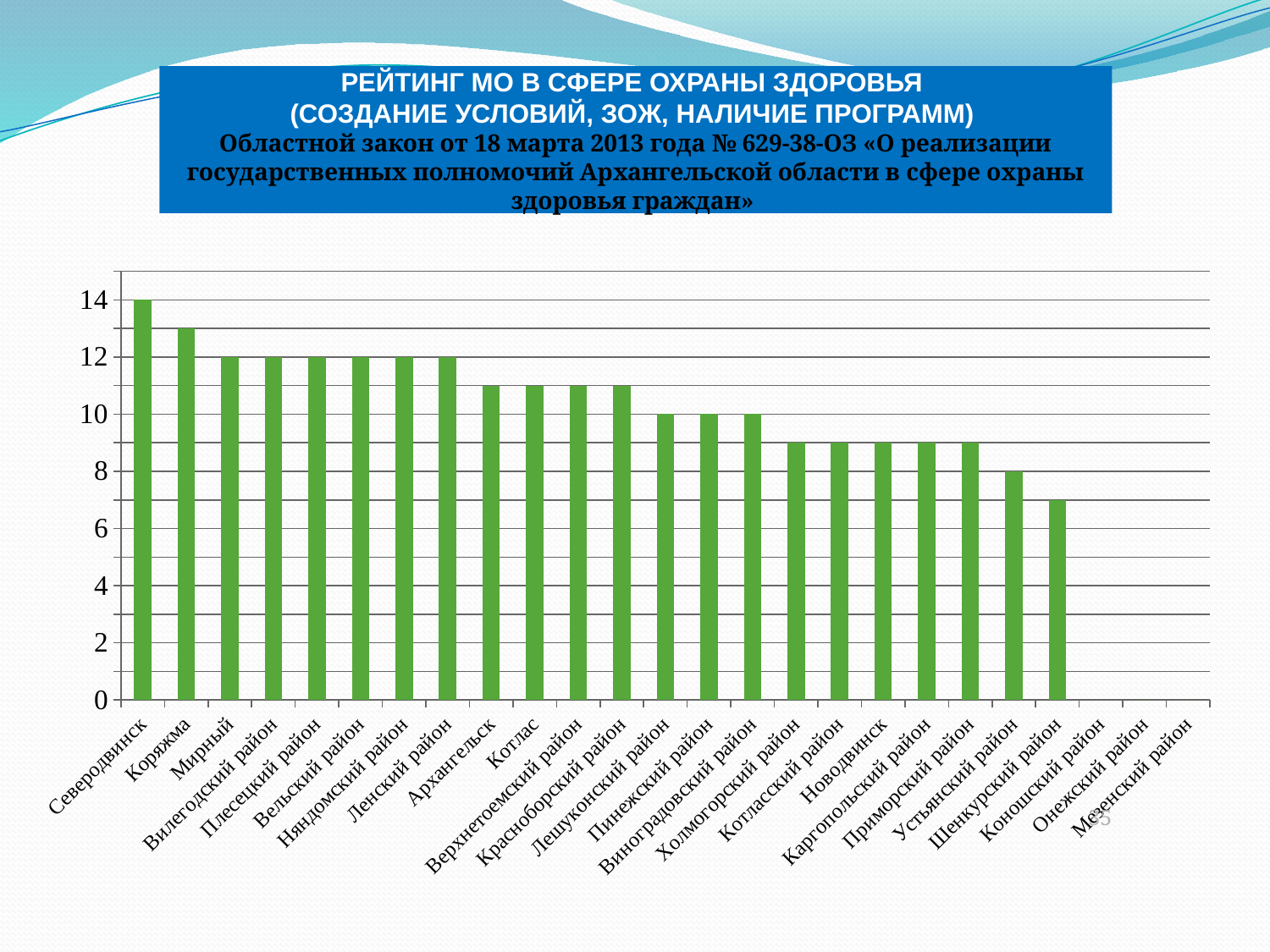
What is the value for Северодвинск? 14 What kind of chart is shown on the slide? Bar chart Which is larger, the value for Коряжма or the value for Мирный? Коряжма Do the values generally rise or fall from left to right along the x axis? Fall What is the value for Шенкурский район? 7 What is the value for Коряжма? 13 What is the difference between the values for Северодвинск and Коношский район? 14 What is the value for Архангельск? 11 How many categories are listed along the x axis? 25 Which category has the highest value in the chart? Северодвинск Is the value for Шенкурский район greater or less than 10? less What is the value for Коношский район? 0